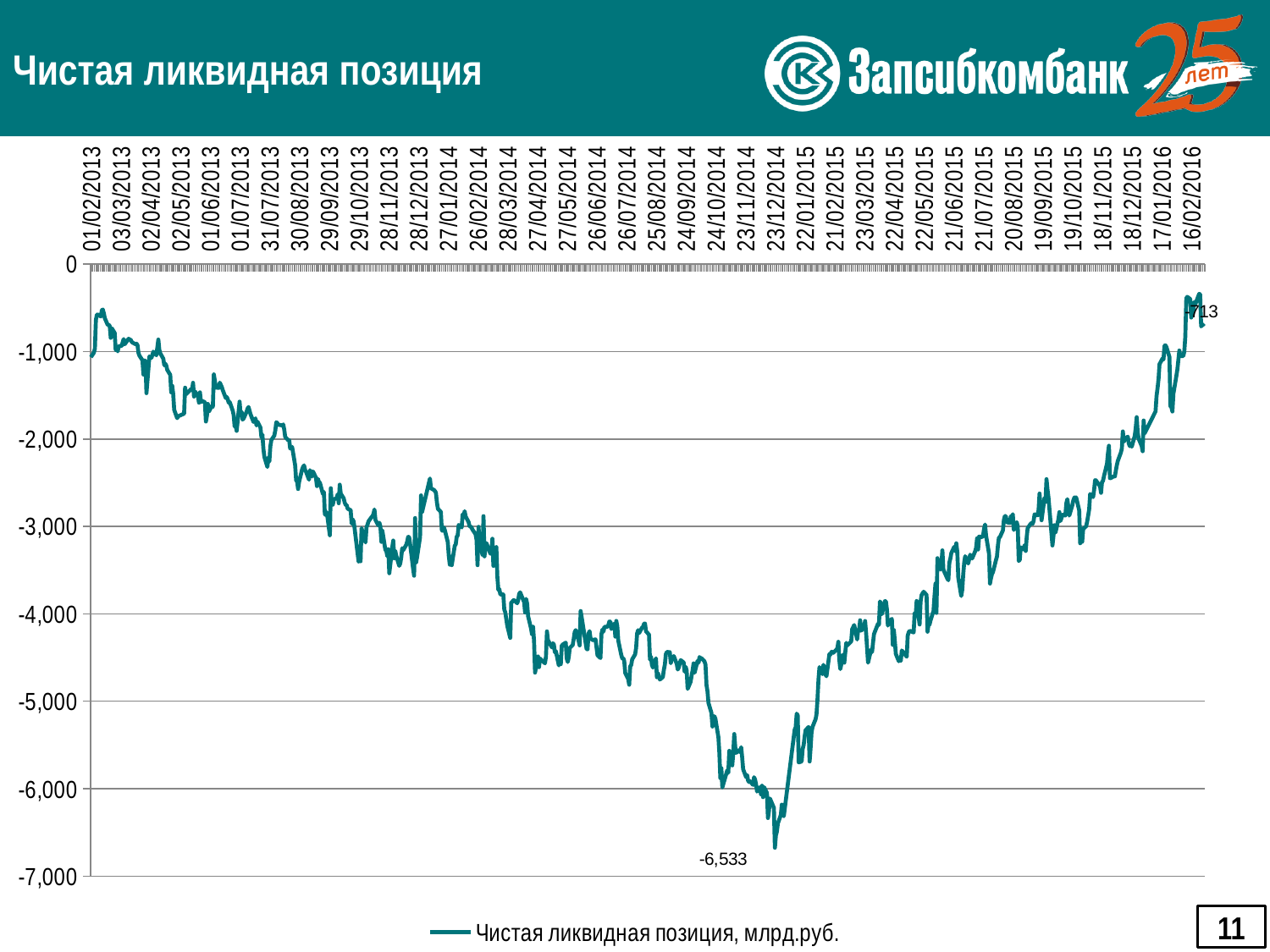
What is the legend entry for the plotted series? Чистая ликвидная позиция, млрд.руб. Is the value around 23/12/2014 greater or less than -6,000? less What is the lowest value labelled on the line? -6,533 What is the difference between the labelled values -713 and -6,533? 5,820 Does the line rise or fall from 01/02/2013 to 24/10/2014? fall What is the title of the chart? Чистая ликвидная позиция Is the value at 01/02/2013 greater or less than -2,000? greater What is the value labelled at the end of the line, near 16/02/2016? -713 Which labelled value is larger, -713 or -6,533? -713 What kind of chart is shown on the slide? line chart How many series does the legend list? 1 Does the line rise or fall from 23/12/2014 to 16/02/2016? rise